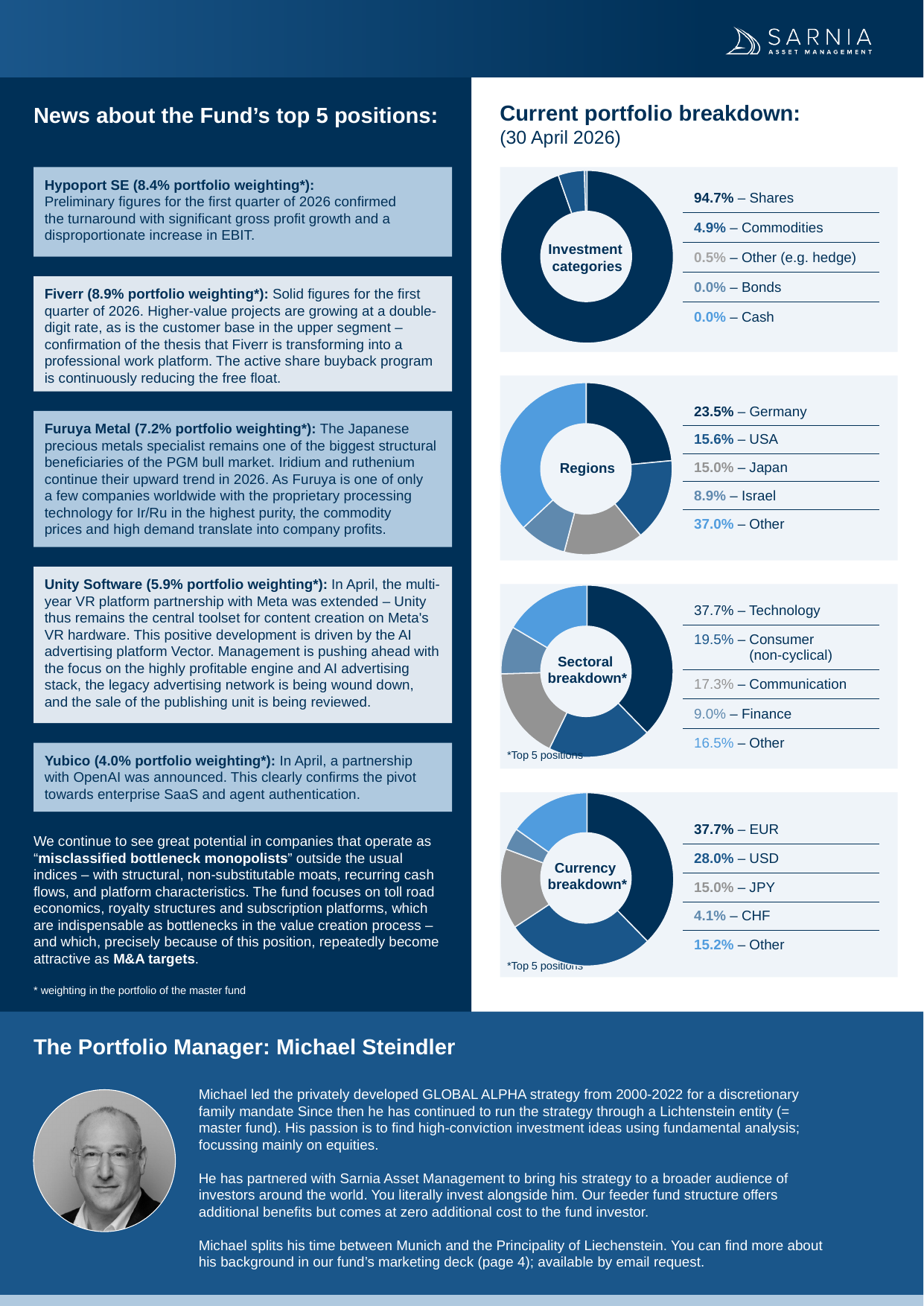
In the Sectoral breakdown chart, what share is Finance? 9.0% In the Regions chart, what is the difference between the USA share and the Japan share? 0.6% In the Investment categories chart, what share is Shares? 94.7% In the Sectoral breakdown chart, which sector has the largest share? Technology What kind of chart is the Regions chart? Donut (pie) chart In the Sectoral breakdown chart, which is larger: Consumer (non-cyclical) or Communication? Consumer (non-cyclical) In the Regions chart, what share is Germany? 23.5% In the Regions chart, which named country has the lowest share? Israel In the Currency breakdown chart, what is the difference between the EUR share and the USD share? 9.7% In the Currency breakdown chart, what share is USD? 28.0% How many categories are listed in the Currency breakdown chart? 5 In the Investment categories chart, what share is Commodities? 4.9%